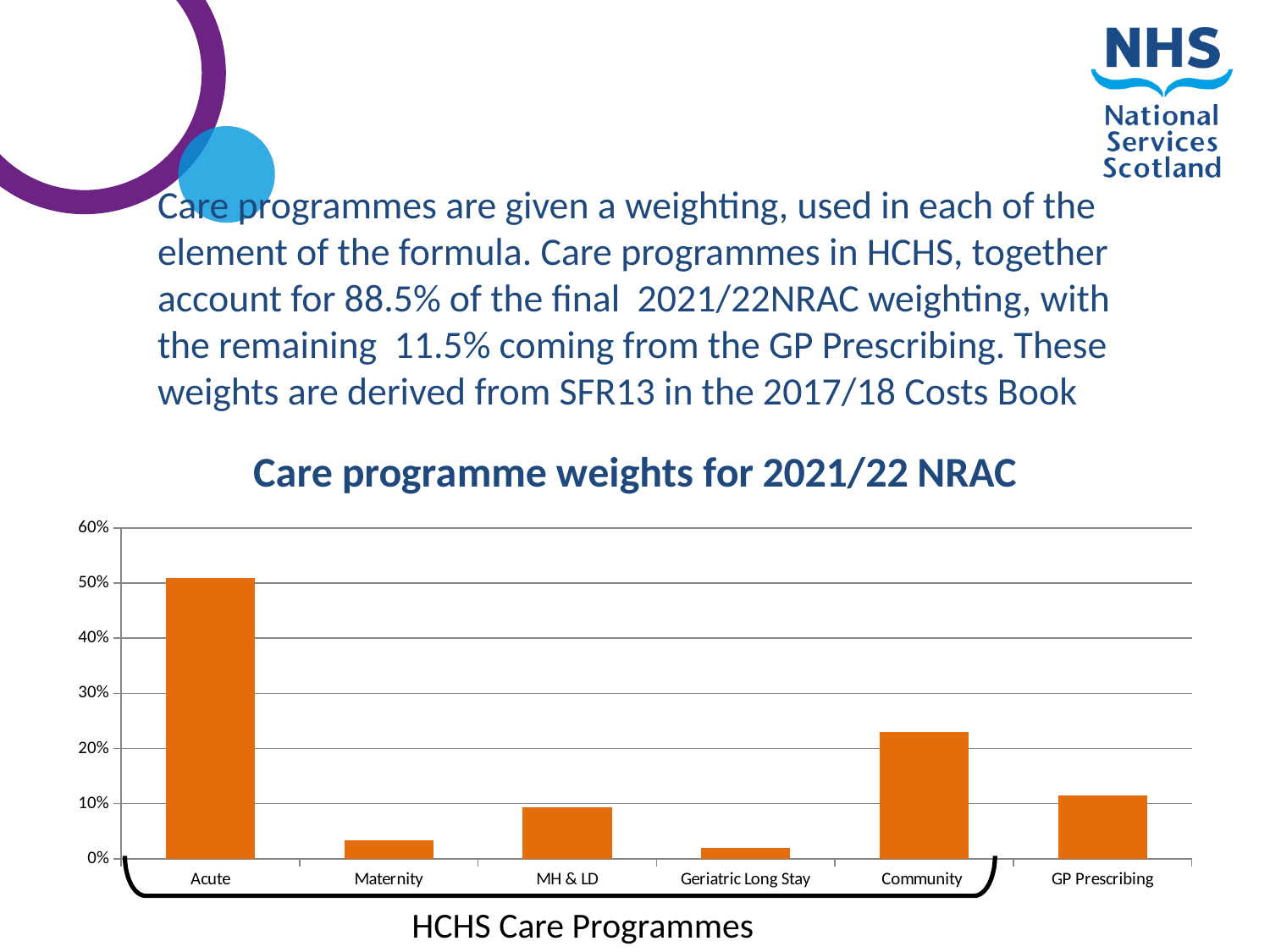
Is the value for Acute greater or less than 50%? greater What kind of chart is shown on the slide? bar chart Which care programme has the lowest weight? Geriatric Long Stay Which has the larger weight, Community or MH & LD? Community Which care programme has the highest weight? Acute What is the title of the chart? Care programme weights for 2021/22 NRAC How many care programme categories are plotted on the chart? 6 Is the value for MH & LD greater or less than 10%? less Is the value for Maternity greater or less than 10%? less What label is shown beneath the bracket grouping the first five categories on the x axis? HCHS Care Programmes Which has the larger weight, Maternity or GP Prescribing? GP Prescribing